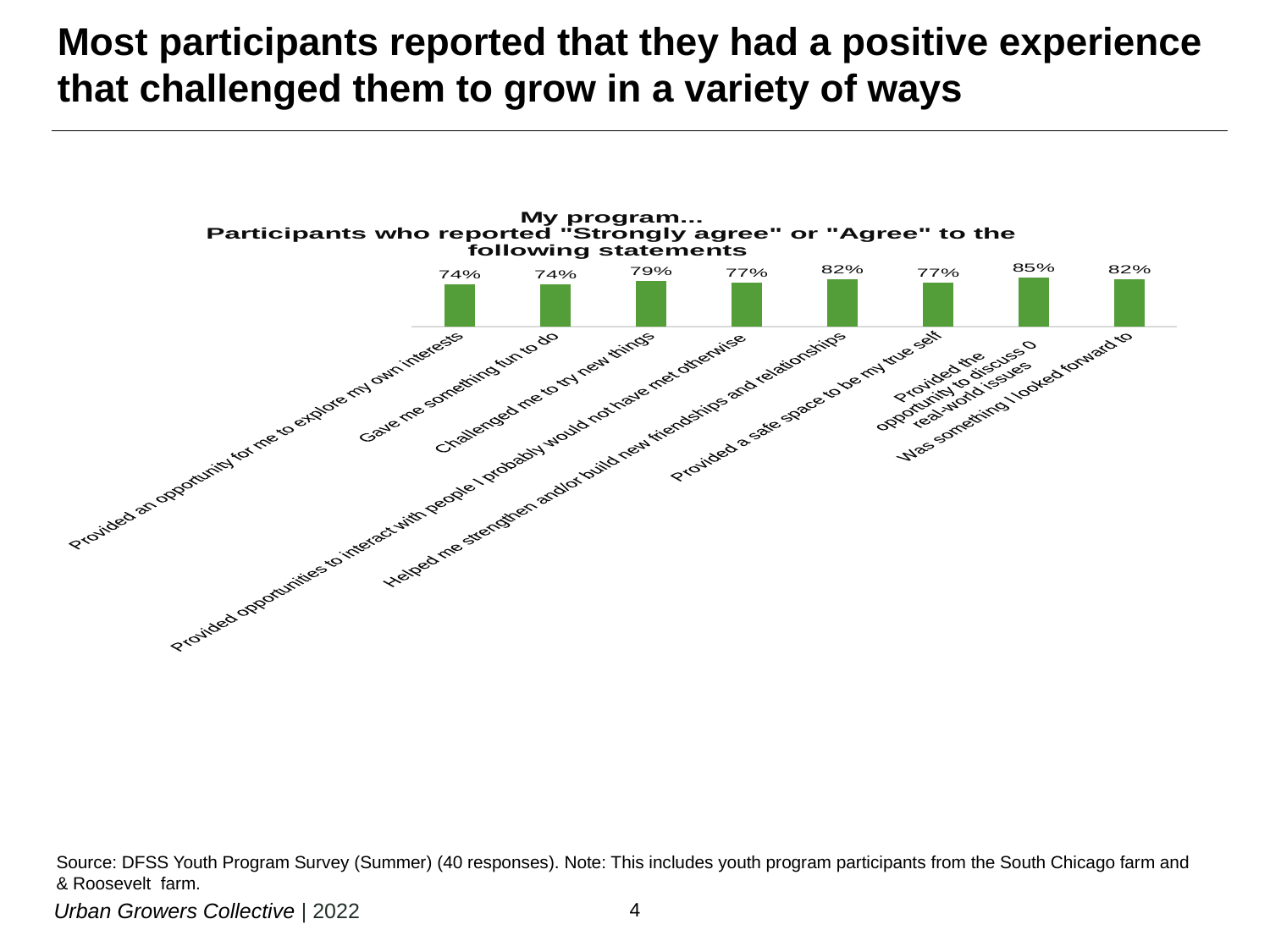
What colour are the bars in the chart? Green How many statements are shown on the chart? 8 What type of chart is shown on the slide? Bar chart How many responses does the source note say the survey had? 40 responses What percentage of participants agreed that their program "Gave me something fun to do"? 74% Which has a higher percentage: "Helped me strengthen and/or build new friendships and relationships" or "Provided a safe space to be my true self"? Helped me strengthen and/or build new friendships and relationships Which statement received the highest share of "Strongly agree" or "Agree" responses? Provided the opportunity to discuss real-world issues What percentage of participants agreed that their program "Challenged me to try new things"? 79% What percentage of participants agreed that their program "Provided a safe space to be my true self"? 77% What percentage of participants agreed that their program "Was something I looked forward to"? 82% What is the lowest percentage shown on the chart? 74% What is the difference between the percentage for "Provided the opportunity to discuss real-world issues" and the percentage for "Provided an opportunity for me to explore my own interests"? 11%